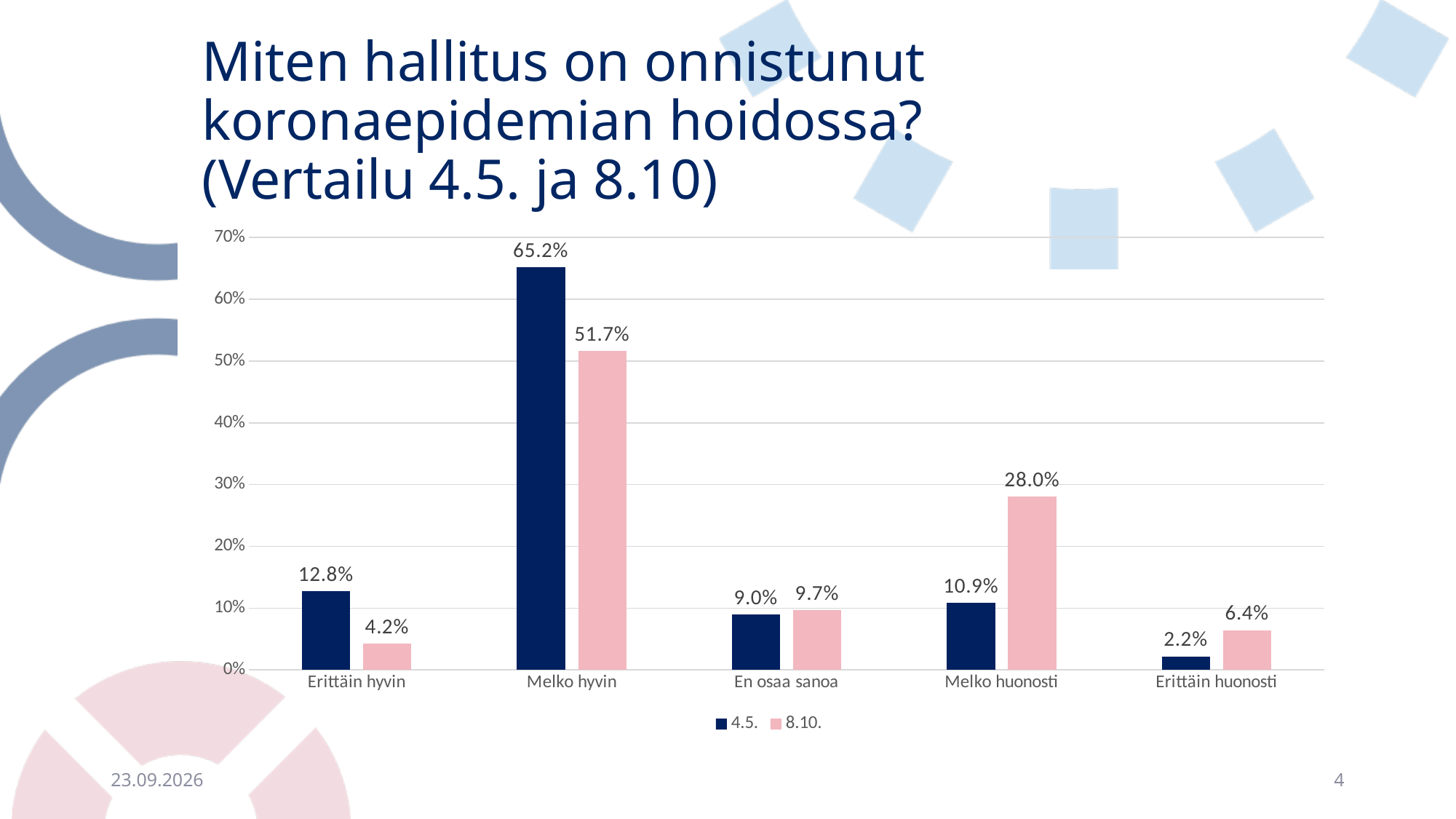
What is the difference between the 4.5. and 8.10. values for "Melko hyvin"? 13.5% What kind of chart is shown on the slide? bar chart What is the value for "Melko huonosti" in the 8.10. series? 28.0% Which category has the lowest value in the 4.5. series? Erittäin huonosti How many series does the legend list? 2 How many categories are shown on the x axis? 5 Which category has the highest value in the 8.10. series? Melko hyvin What is the value for "Erittäin hyvin" in the 8.10. series? 4.2% Which colour represents the 8.10. series in the legend? pink Is the 4.5. value for "Melko hyvin" greater or less than 60%? greater For "Melko huonosti", which series has the larger value, 4.5. or 8.10.? 8.10. What is the value for "Melko hyvin" in the 4.5. series? 65.2%